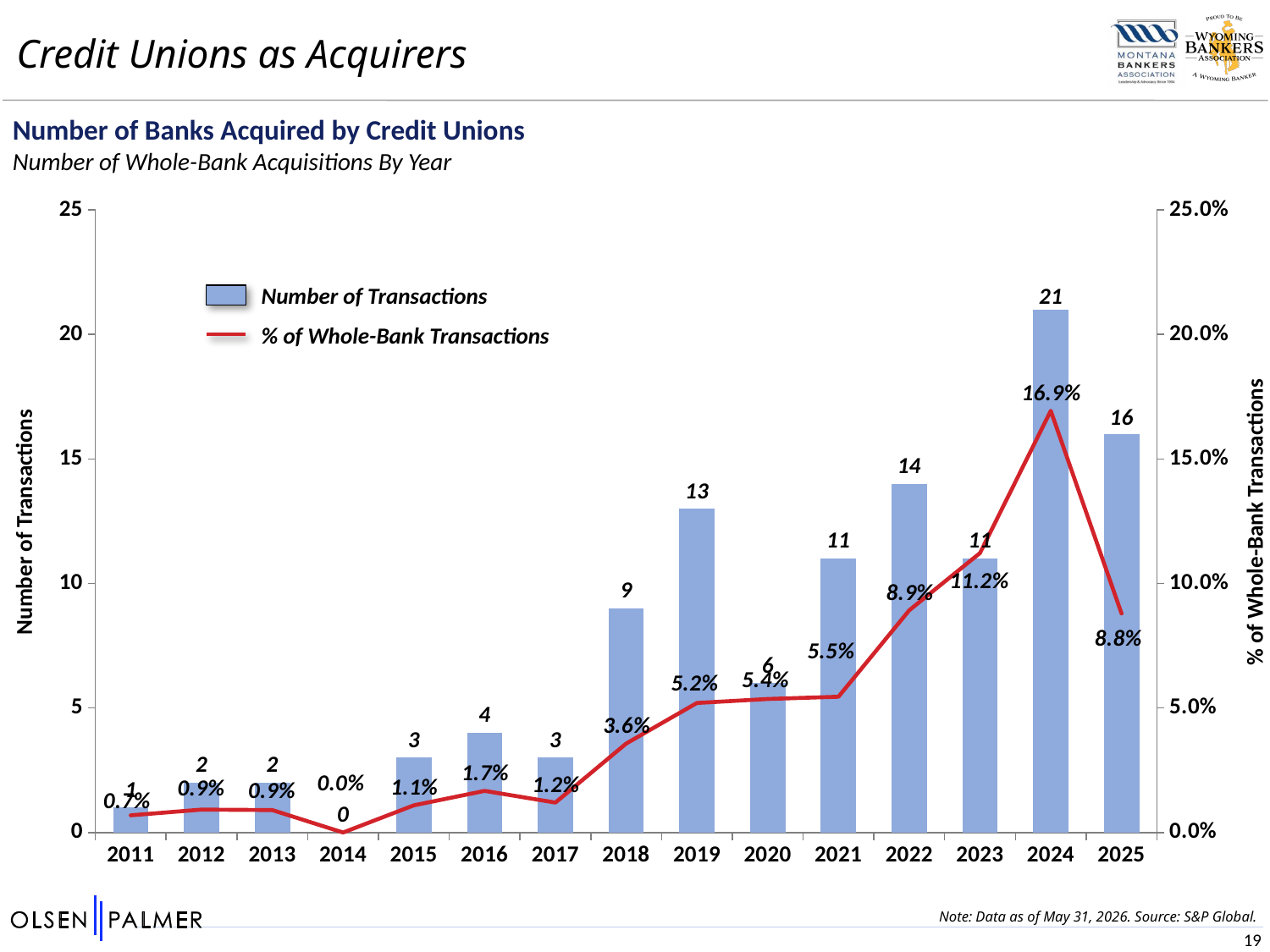
What kind of chart is used to show the Number of Transactions series? Bar chart What is the title of the chart? Number of Banks Acquired by Credit Unions Which year has the lowest Number of Transactions? 2014 How many series does the chart legend list? 2 What is the difference in Number of Transactions between 2024 and 2025? 5 How many banks were acquired by credit unions in 2024 according to the Number of Transactions series? 21 Which year has a higher % of Whole-Bank Transactions, 2022 or 2025? 2022 Which year has the highest Number of Transactions? 2024 How many years are shown on the x axis of the chart? 15 What is the % of Whole-Bank Transactions value for 2023? 11.2% Is the Number of Transactions for 2021 greater or less than 10? greater What is the Number of Transactions value for 2019? 13